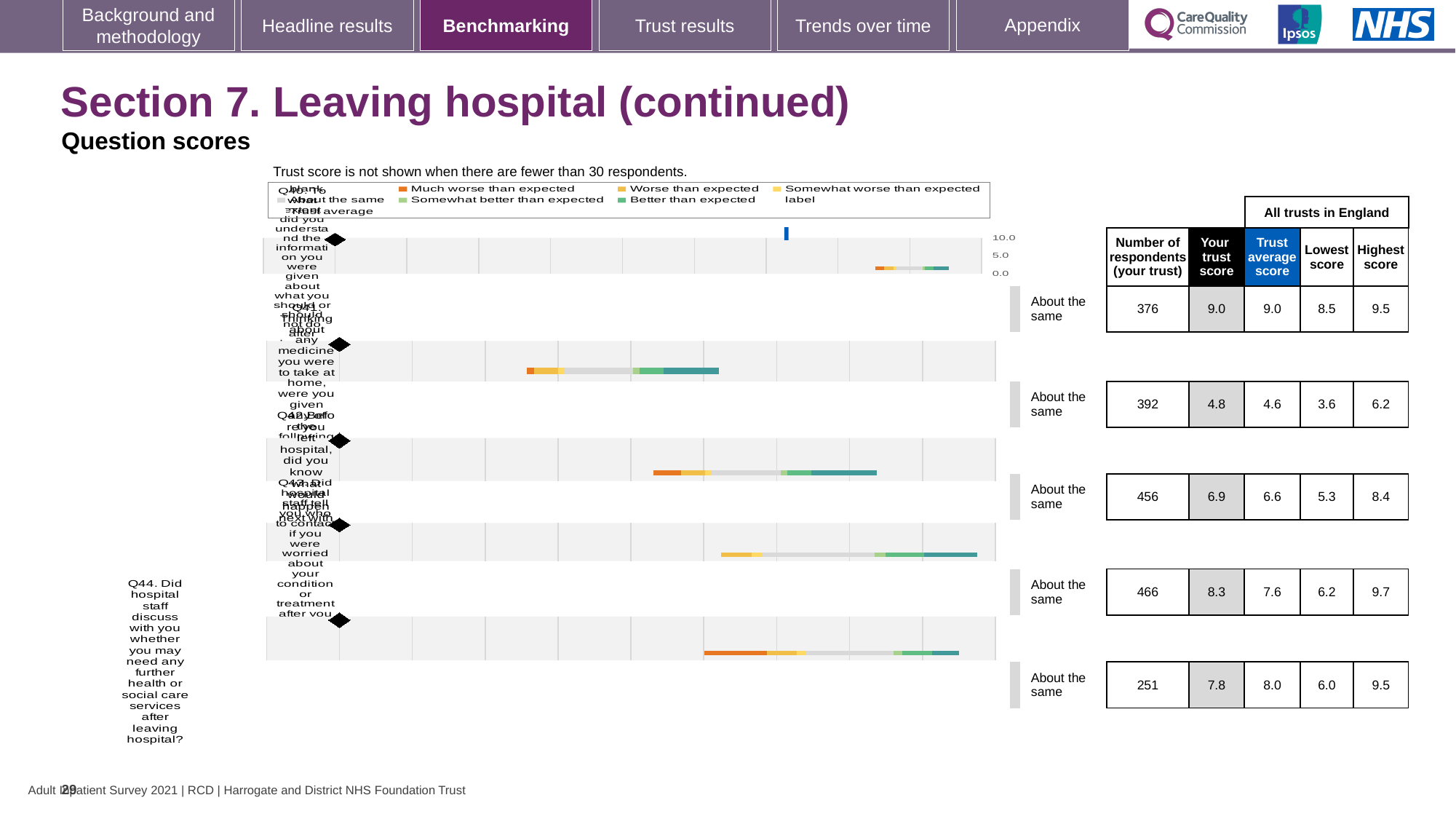
How many questions (rows) are plotted in the question scores chart? 5 For Q44, which is larger: the trust's own score or the trust average score? Trust average score (8.0) What benchmark category is shown next to every question row in the chart? About the same What is the 'Your trust score' for the first question row in the table? 9.0 What is the 'Trust average score' for Q44? 8.0 What is the highest number of respondents shown in the table? 466 What kind of chart is used to show the question scores on this slide? bar chart How many respondents from the trust answered Q44? 251 Is the 'Your trust score' for Q44 greater or less than 5.0? greater For Q44, what is the difference between the highest score and the lowest score across all trusts in England? 3.5 What is the 'Your trust score' for Q44 (whether hospital staff discussed further health or social care services after leaving hospital)? 7.8 Which question row has the lowest number of respondents? Q44 (251)